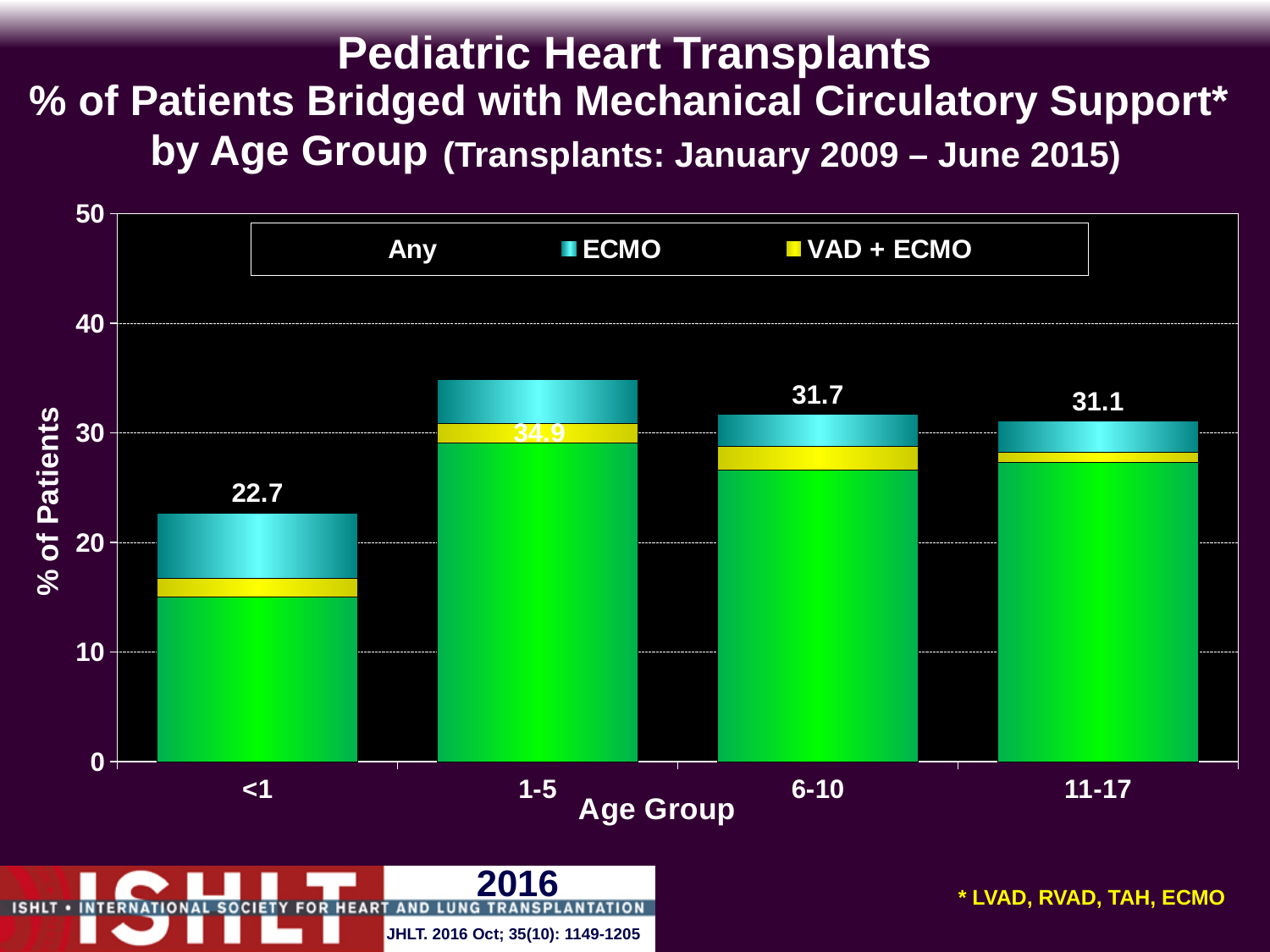
What is the difference between the values for the 1-5 and <1 age groups? 12.2 Which is larger, the value for the 6-10 age group or the 11-17 age group? 6-10 What is the value for the 11-17 age group? 31.1 What is the value for the <1 age group? 22.7 Is the value for the <1 age group greater or less than 20? greater Which age group has the highest percentage of patients bridged with mechanical circulatory support? 1-5 What kind of chart is shown on the slide? Bar chart How many age groups are shown on the x axis? 4 Which age group has the lowest percentage of patients bridged with mechanical circulatory support? <1 How many series does the legend list? 3 What is the value for the 6-10 age group? 31.7 What is the value for the 1-5 age group? 34.9